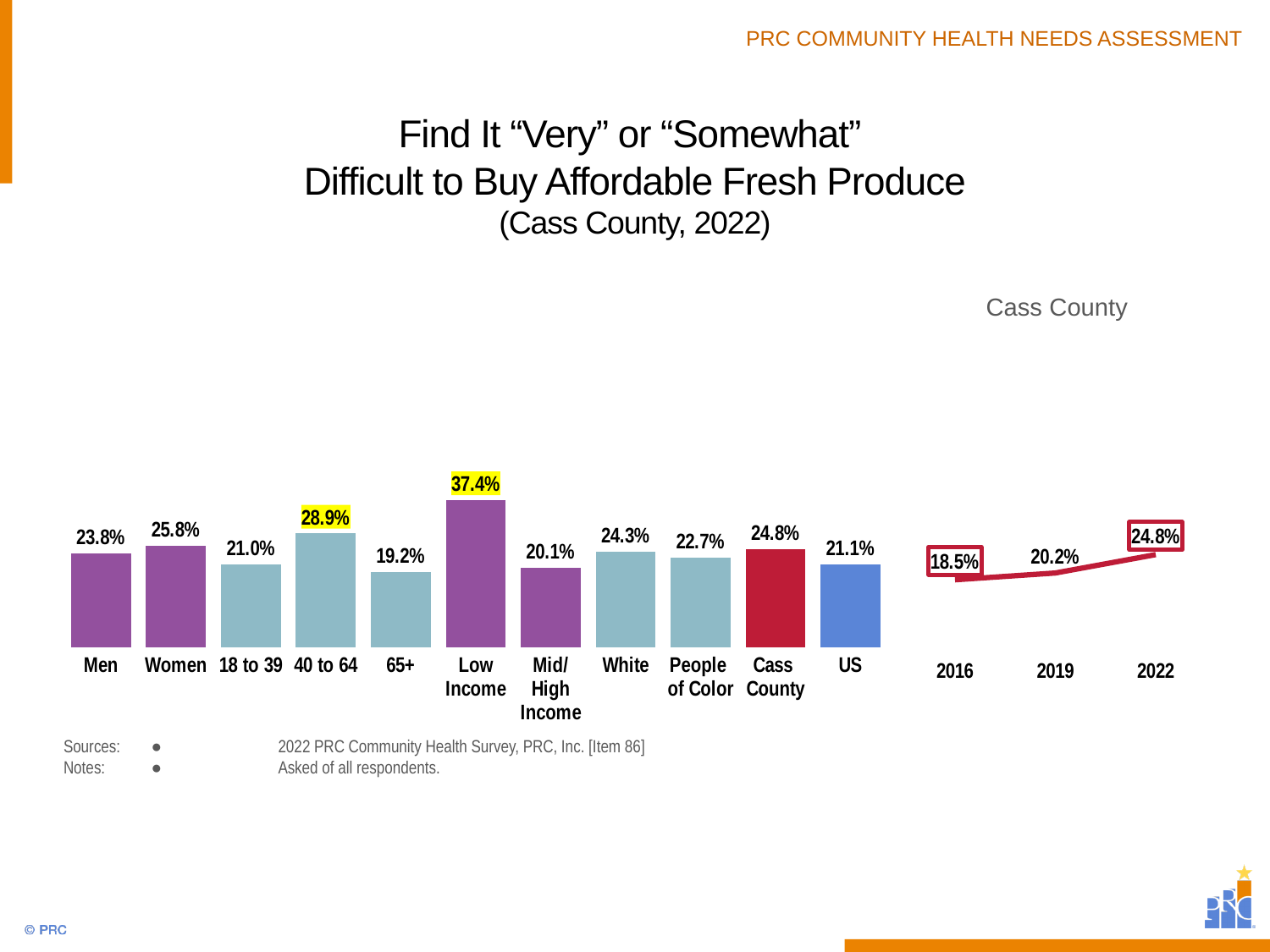
In the bar chart on the left, which category has the highest value? Low Income In the Cass County trend chart on the right, what is the difference between the 2022 and 2016 values? 6.3% In the bar chart on the left, how many categories are shown? 11 In the bar chart on the left, which is larger, the value for Men or the value for Women? Women In the bar chart on the left, what is the value for Women? 25.8% In the bar chart on the left, which category has the lowest value? 65+ In the bar chart on the left, what is the difference between the Low Income and Mid/High Income values? 17.3% What kind of chart is the chart on the left? bar chart In the bar chart on the left, what is the difference between the Cass County and US values? 3.7% In the bar chart on the left, what is the value for Low Income? 37.4% In the Cass County trend chart on the right, do the values rise or fall from 2016 to 2022? rise In the Cass County trend chart on the right, what is the value for 2016? 18.5%